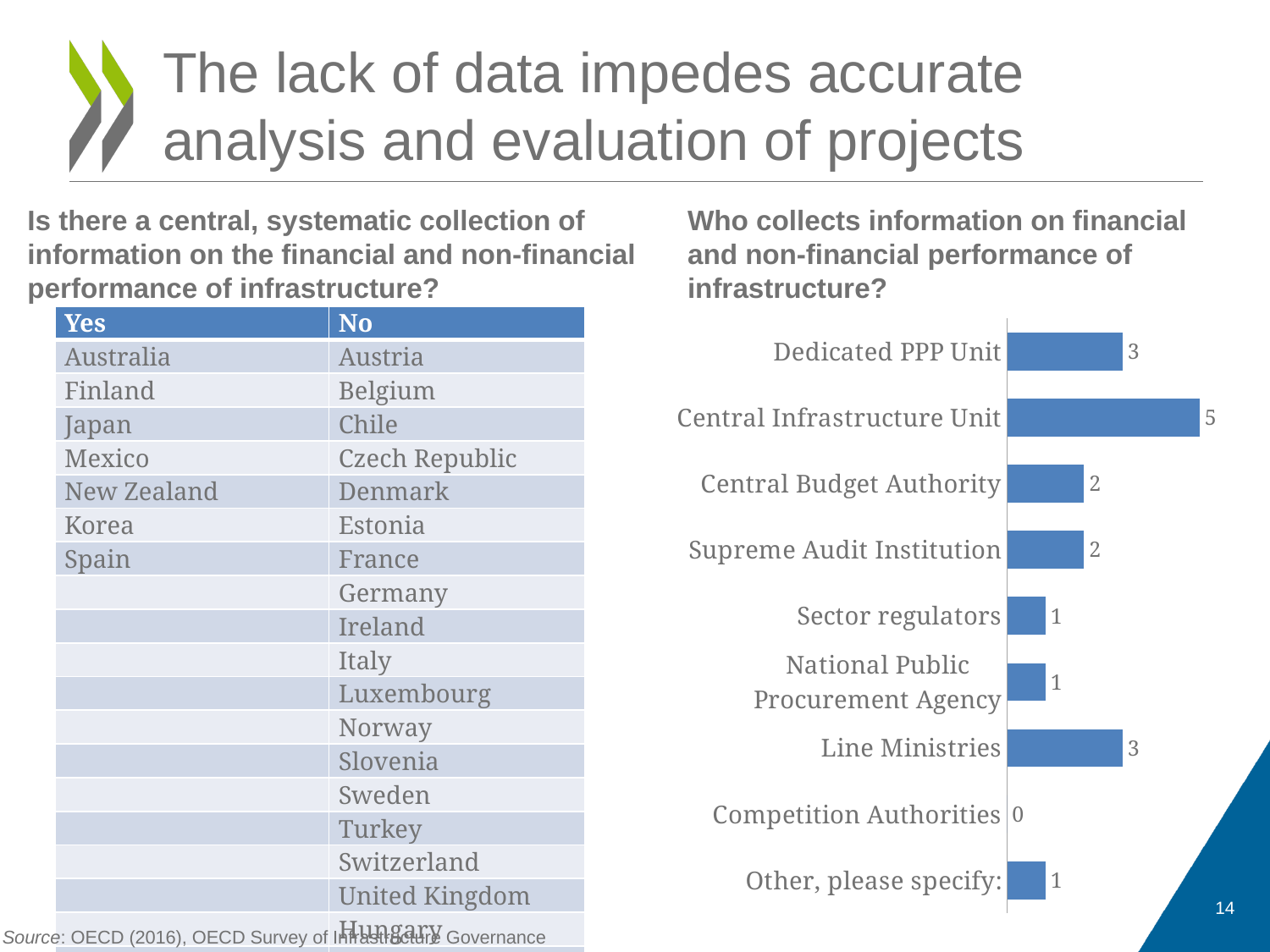
What value is shown for Competition Authorities? 0 What value is shown for Central Infrastructure Unit? 5 What kind of chart is shown on the slide? Bar chart What value is shown for Dedicated PPP Unit? 3 What is the difference between the values for Central Infrastructure Unit and Line Ministries? 2 Which category has the highest value? Central Infrastructure Unit What is the difference between the values for Dedicated PPP Unit and National Public Procurement Agency? 2 Which is larger, the value for Central Budget Authority or the value for Sector regulators? Central Budget Authority How many categories are shown in the chart? 9 What value is shown for Supreme Audit Institution? 2 Which category has the lowest value? Competition Authorities What is the title of the chart? Who collects information on financial and non-financial performance of infrastructure?